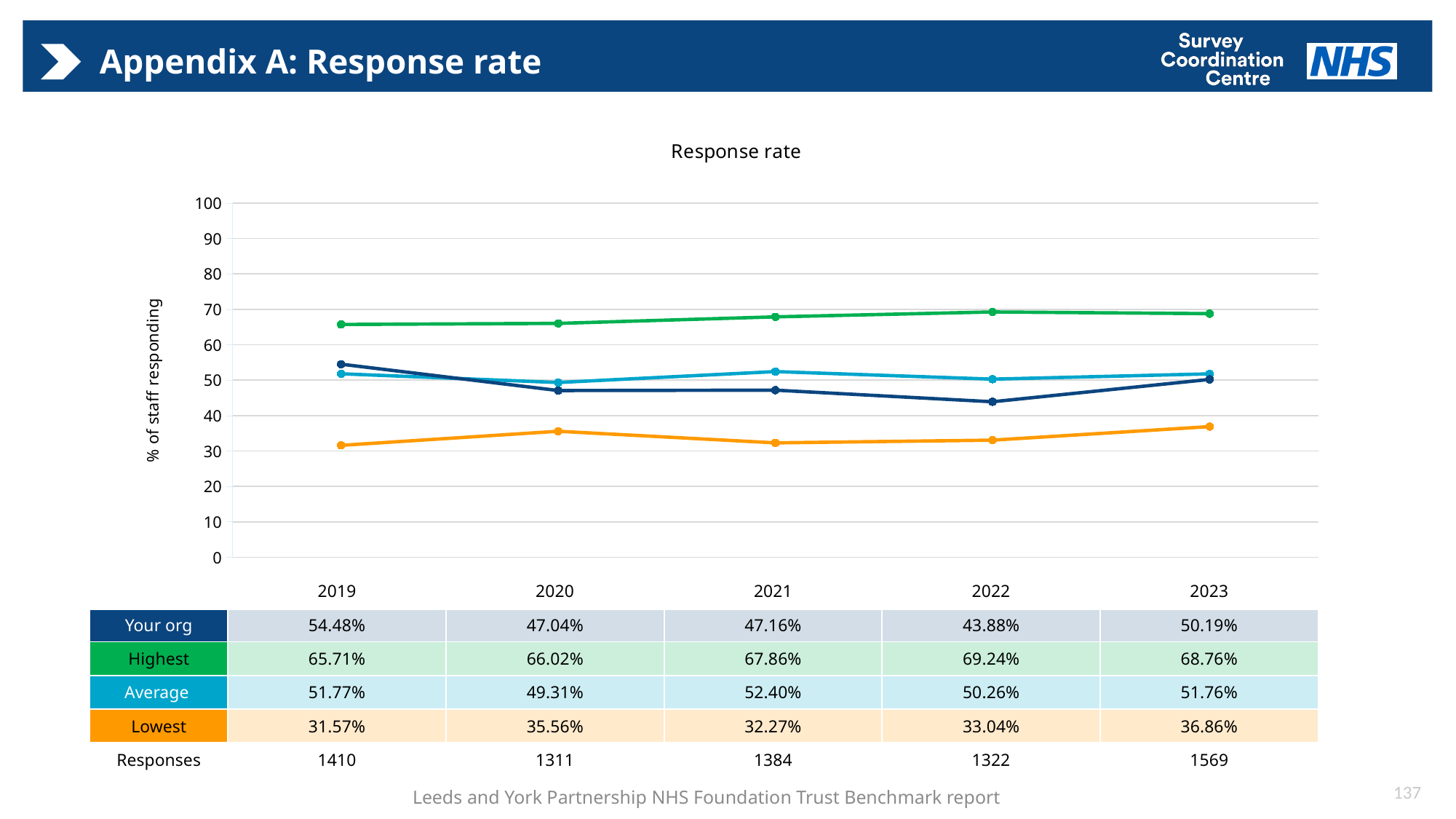
How many responses were recorded in 2023? 1569 What is the Lowest response rate in 2019? 31.57% What is the difference between the Highest and Your org response rates in 2021? 20.70% Which is larger in 2019: Your org or Average? Your org What is the Average response rate in 2020? 49.31% In which year was the Your org response rate highest? 2019 How many series are plotted on the chart? 4 What is the Highest response rate shown for 2022? 69.24% In which year was the Your org response rate lowest? 2022 How many years are shown on the x axis? 5 What is the response rate for Your org in 2023? 50.19% What type of chart is shown? Line chart